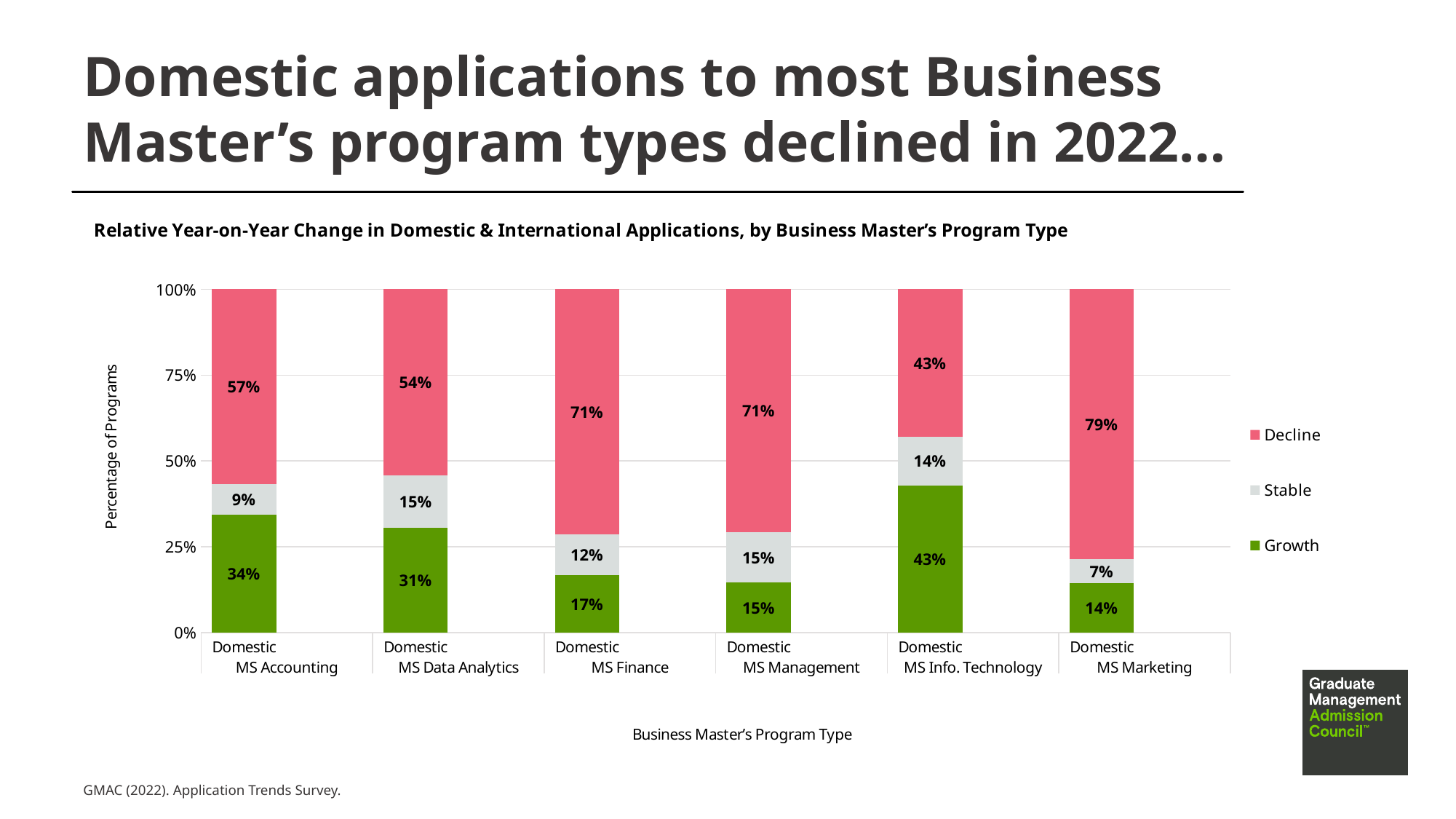
What is the total of the Stable and Growth segments for Domestic MS Management? 30% What is the Stable value for Domestic MS Data Analytics? 15% How many series does the legend list? 3 What kind of chart is shown on the slide? Stacked bar chart What is the Decline value for Domestic MS Marketing? 79% What is the Growth value for Domestic MS Info. Technology? 43% Which colour represents the Growth series in the legend? Green How many program types are shown on the x axis? 6 Which program type has the lowest Growth share? Domestic MS Marketing Which is larger, the Decline value for Domestic MS Accounting or for Domestic MS Data Analytics? Domestic MS Accounting What is the difference between the Growth values for Domestic MS Accounting and Domestic MS Finance? 17% Which program type has the highest Decline share? Domestic MS Marketing